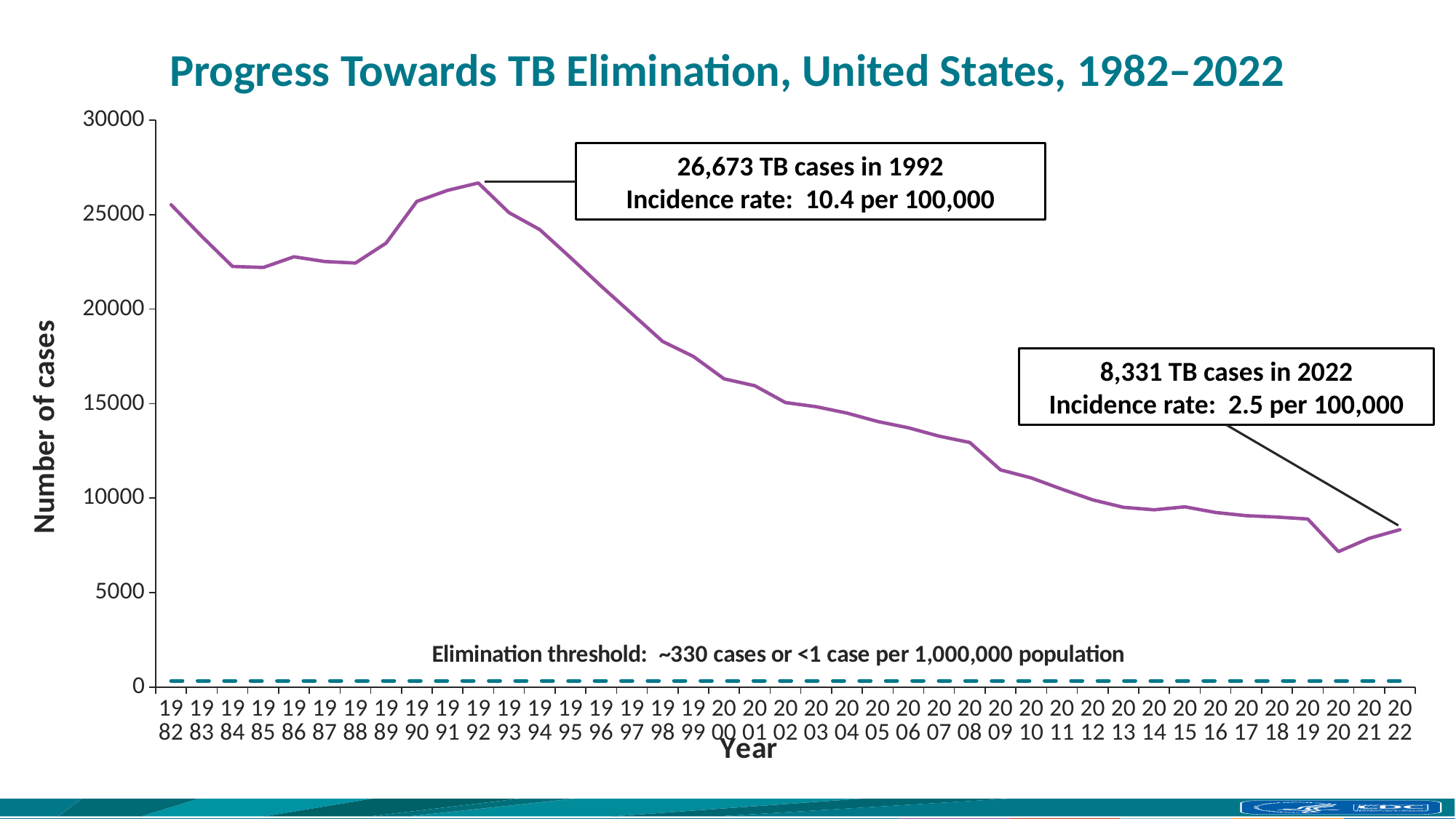
Is the number of cases in 1998 greater or less than 15000? greater What was the TB incidence rate in 2022? 2.5 per 100,000 In which year does the line reach its highest number of cases? 1992 Do the number of cases rise or fall from 1992 to 2022? Fall Which year has more TB cases, 1984 or 1990? 1990 How many TB cases were reported in 2022 according to the annotation? 8,331 In which year does the line reach its lowest number of cases? 2020 What kind of chart is shown on the slide? Line chart How many TB cases were reported in 1992 according to the annotation? 26,673 What is the label of the y-axis? Number of cases What was the TB incidence rate in 1992? 10.4 per 100,000 What is the difference between the number of TB cases in 1992 and in 2022? 18,342